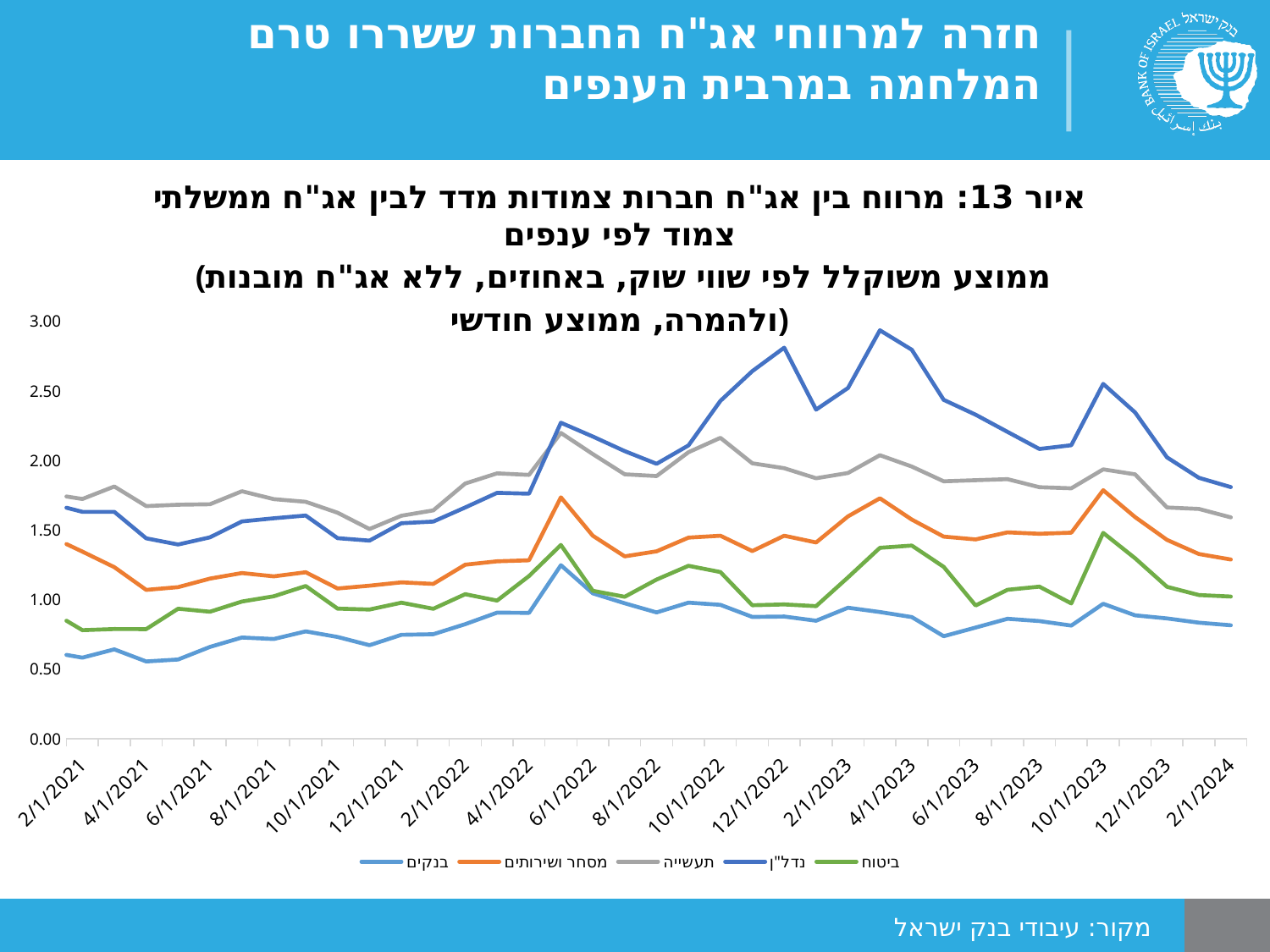
Which series has the lowest values across the whole period? בנקים Which series are listed in the legend? בנקים, מסחר ושירותים, תעשייה, נדל"ן, ביטוח At 2/1/2024, which is larger: the value for נדל"ן or the value for בנקים? נדל"ן Is the value for מסחר ושירותים at 10/1/2023 greater or less than 1.50? greater Is the value for בנקים at 2/1/2021 greater or less than 1.00? less How many series does the legend list? 5 What kind of chart is shown on the slide? Line chart Which series has the highest value at 4/1/2023? נדל"ן How many date labels are shown on the x axis? 19 What is the figure number given in the chart title? איור 13 Is the value for נדל"ן at 2/1/2024 greater or less than 2.00? less